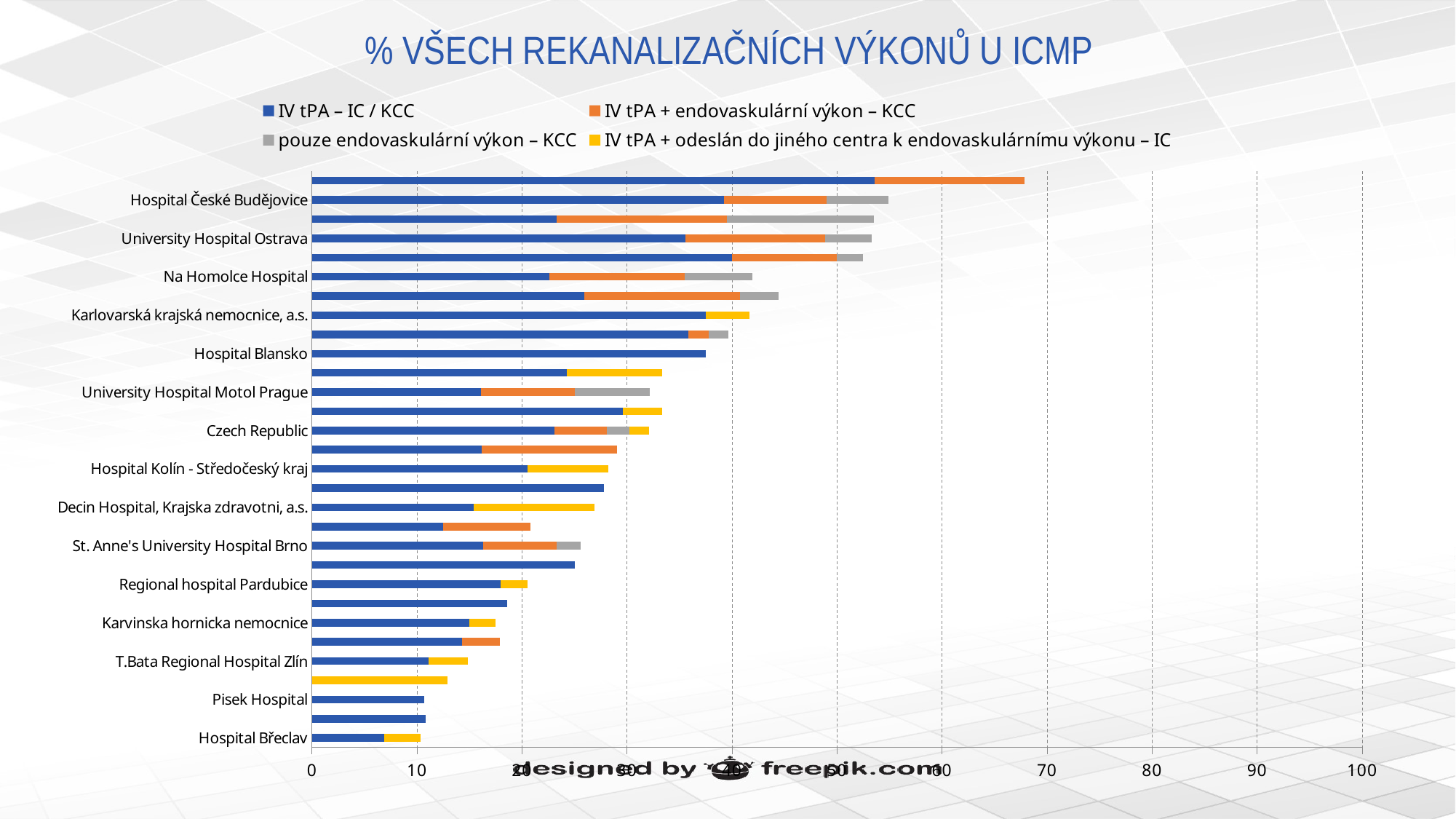
What is the title of the chart? % VŠECH REKANALIZAČNÍCH VÝKONŮ U ICMP What kind of chart is shown on the slide? Bar chart Is the IV tPA – IC / KCC value for Na Homolce Hospital greater or less than 30? less Is the total bar length for Hospital České Budějovice greater or less than 50? greater Is the total bar length for Pisek Hospital greater or less than 20? less Which series is shown in yellow in the legend? IV tPA + odeslán do jiného centra k endovaskulárnímu výkonu – IC Which has the longer total bar, Hospital Blansko or Hospital Břeclav? Hospital Blansko Which has the longer total bar, Hospital České Budějovice or Czech Republic? Hospital České Budějovice How many series does the legend list? 4